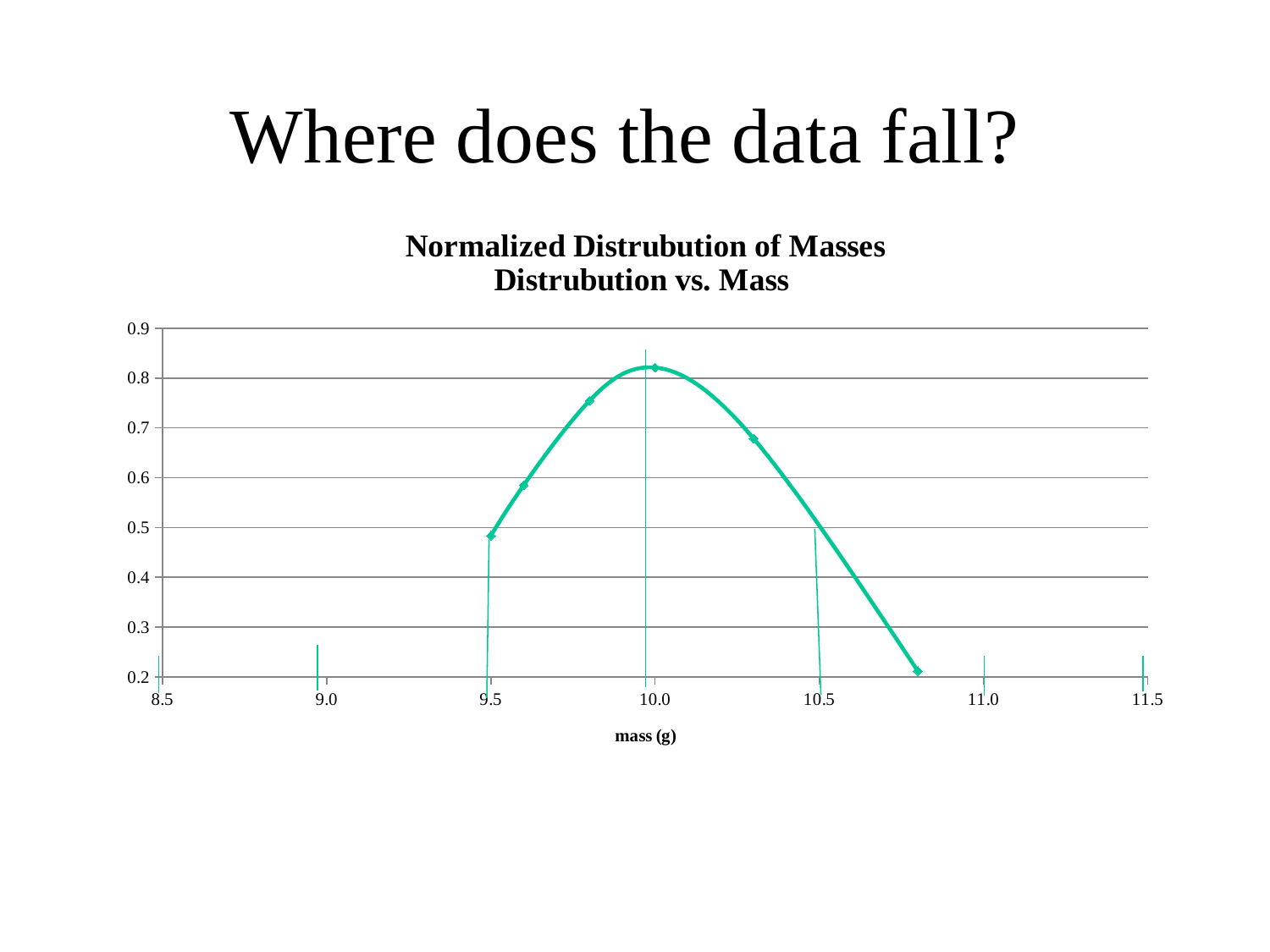
What is the label on the x axis of the chart? mass (g) Is the value at mass 10.0 greater or less than 0.8? greater What is the title of the chart? Normalized Distrubution of Masses Distrubution vs. Mass Is the value at mass 9.8 greater or less than 0.7? greater What kind of chart is shown on the slide? line chart At which mass does the curve reach its lowest value? 10.8 Which has the larger value, the point at mass 9.8 or the point at mass 10.3? 9.8 How do the values change as mass increases from 10.0 to 10.8? they fall At which mass does the curve reach its highest value? 10.0 Is the value at mass 9.5 greater or less than 0.5? less How many data points are marked on the curve? 6